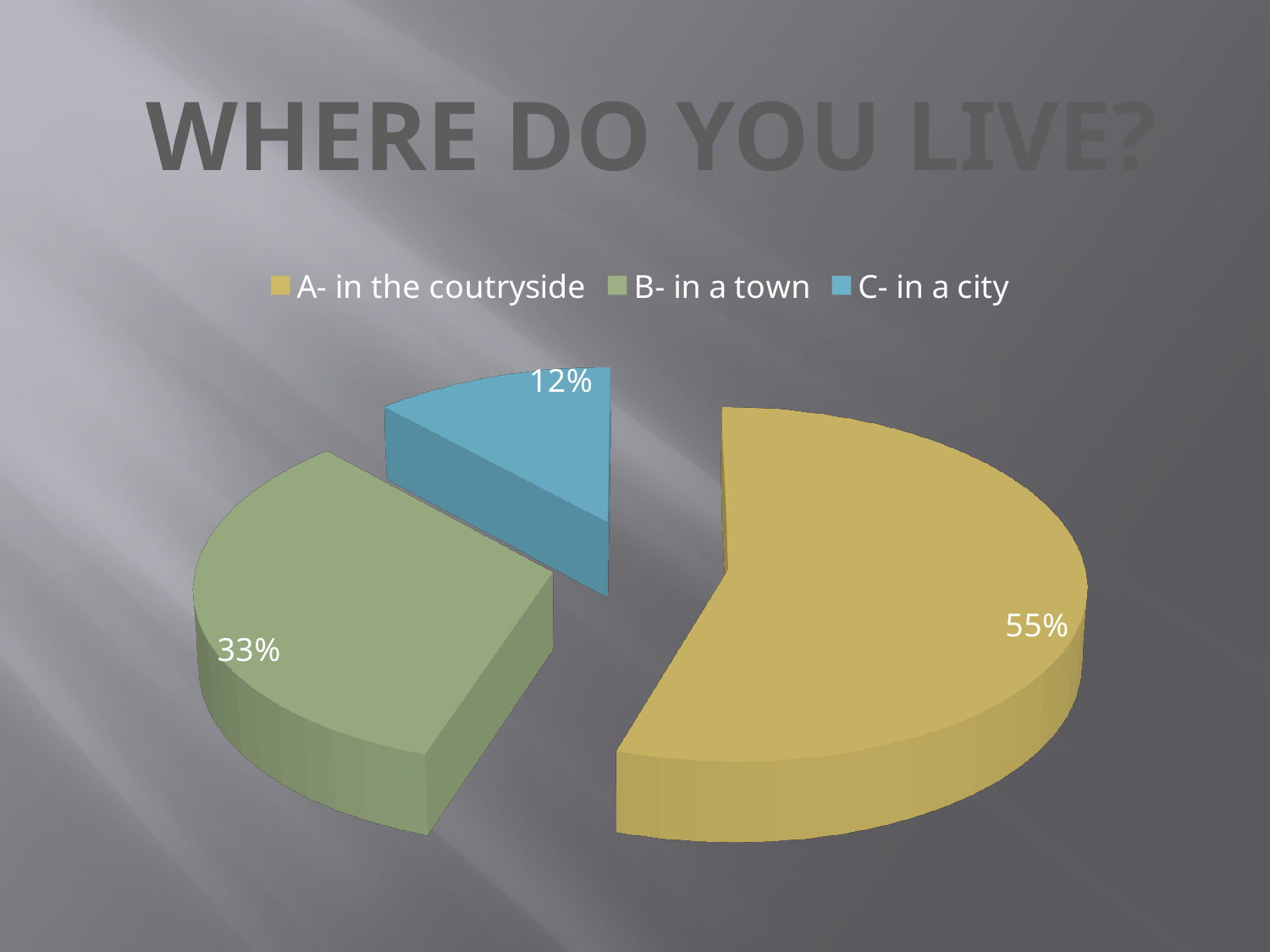
Which category has the largest slice of the pie? A- in the coutryside Which category has the smallest slice of the pie? C- in a city What colour is the slice for 'C- in a city'? Blue What share of the pie is labelled for 'B- in a town'? 33% What share of the pie is labelled for 'C- in a city'? 12% What is the difference in percentage points between 'B- in a town' and 'C- in a city'? 21 What kind of chart is shown on the slide? Pie chart What is the title of the slide containing the chart? WHERE DO YOU LIVE? Which is larger, the slice for 'B- in a town' or the slice for 'C- in a city'? B- in a town What share of the pie is labelled for 'A- in the coutryside'? 55% What is the difference in percentage points between 'A- in the coutryside' and 'B- in a town'? 22 How many slices does the pie chart have? 3